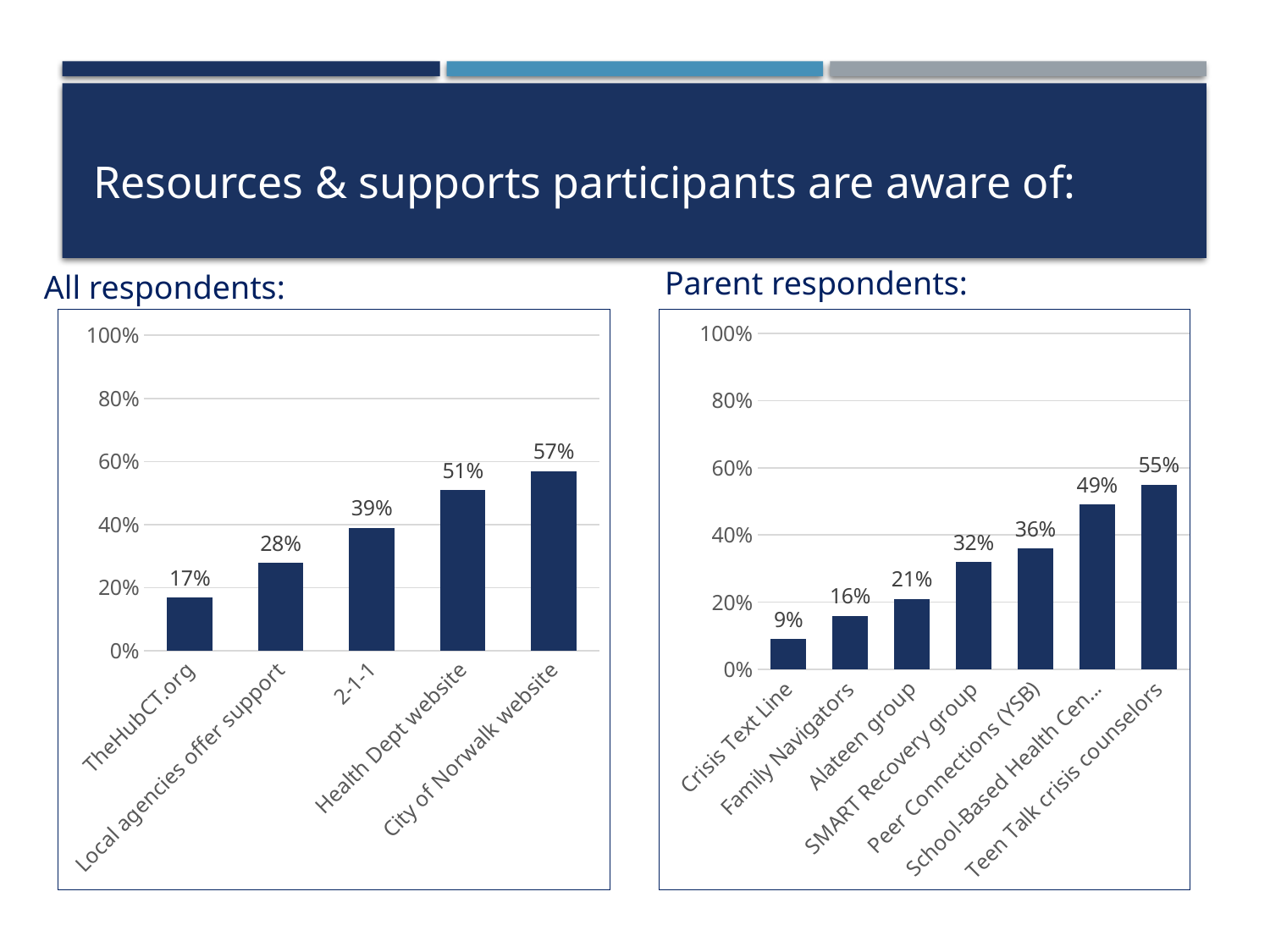
In the 'Parent respondents' chart, which category has the lowest value? Crisis Text Line In the 'All respondents' chart, which category has the lowest value? TheHubCT.org In the 'All respondents' chart, what is the value for 2-1-1? 39% In the 'Parent respondents' chart, which category has the highest value? Teen Talk crisis counselors In the 'Parent respondents' chart, which is larger: the value for SMART Recovery group or the value for Family Navigators? SMART Recovery group In the 'Parent respondents' chart, how many categories are shown? 7 What kind of chart is the 'All respondents' chart? Bar chart In the 'Parent respondents' chart, what is the value for Alateen group? 21% In the 'All respondents' chart, what is the difference between the values for Health Dept website and Local agencies offer support? 23% In the 'Parent respondents' chart, what is the value for Peer Connections (YSB)? 36% In the 'All respondents' chart, how many categories are shown? 5 In the 'All respondents' chart, which category has the highest value? City of Norwalk website